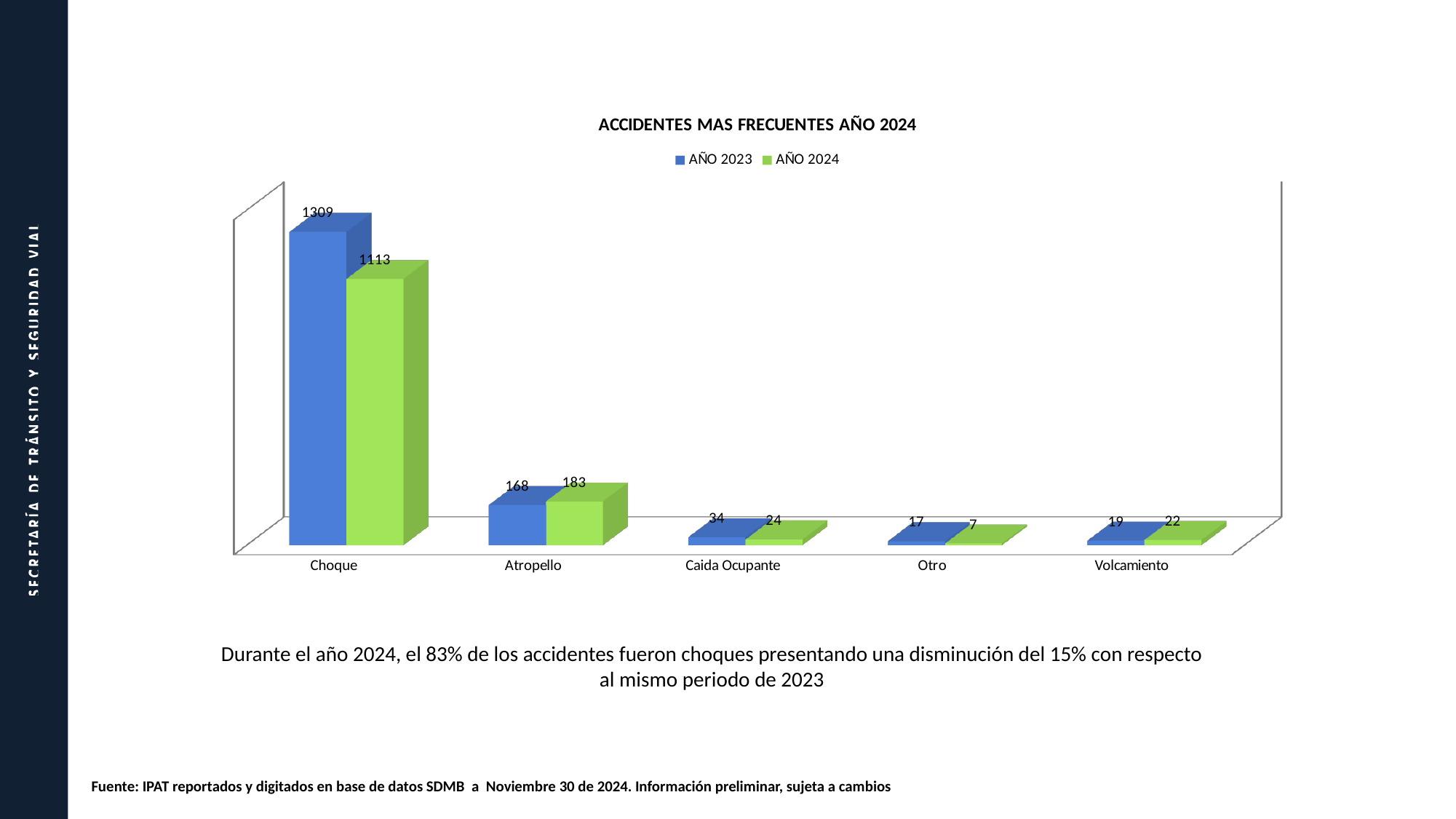
What is the value for Atropello in the AÑO 2024 series? 183 How many categories are shown on the x axis? 5 What kind of chart is shown on the slide? Bar chart Which category has the highest value in the AÑO 2023 series? Choque What is the title of the chart? ACCIDENTES MAS FRECUENTES AÑO 2024 What is the value for Choque in the AÑO 2024 series? 1113 What is the value for Choque in the AÑO 2023 series? 1309 Which category has the lowest value in the AÑO 2024 series? Otro How many series does the legend list? 2 What is the value for Otro in the AÑO 2024 series? 7 What is the difference between the AÑO 2023 and AÑO 2024 values for Choque? 196 Which is larger for Atropello, the AÑO 2023 value or the AÑO 2024 value? AÑO 2024